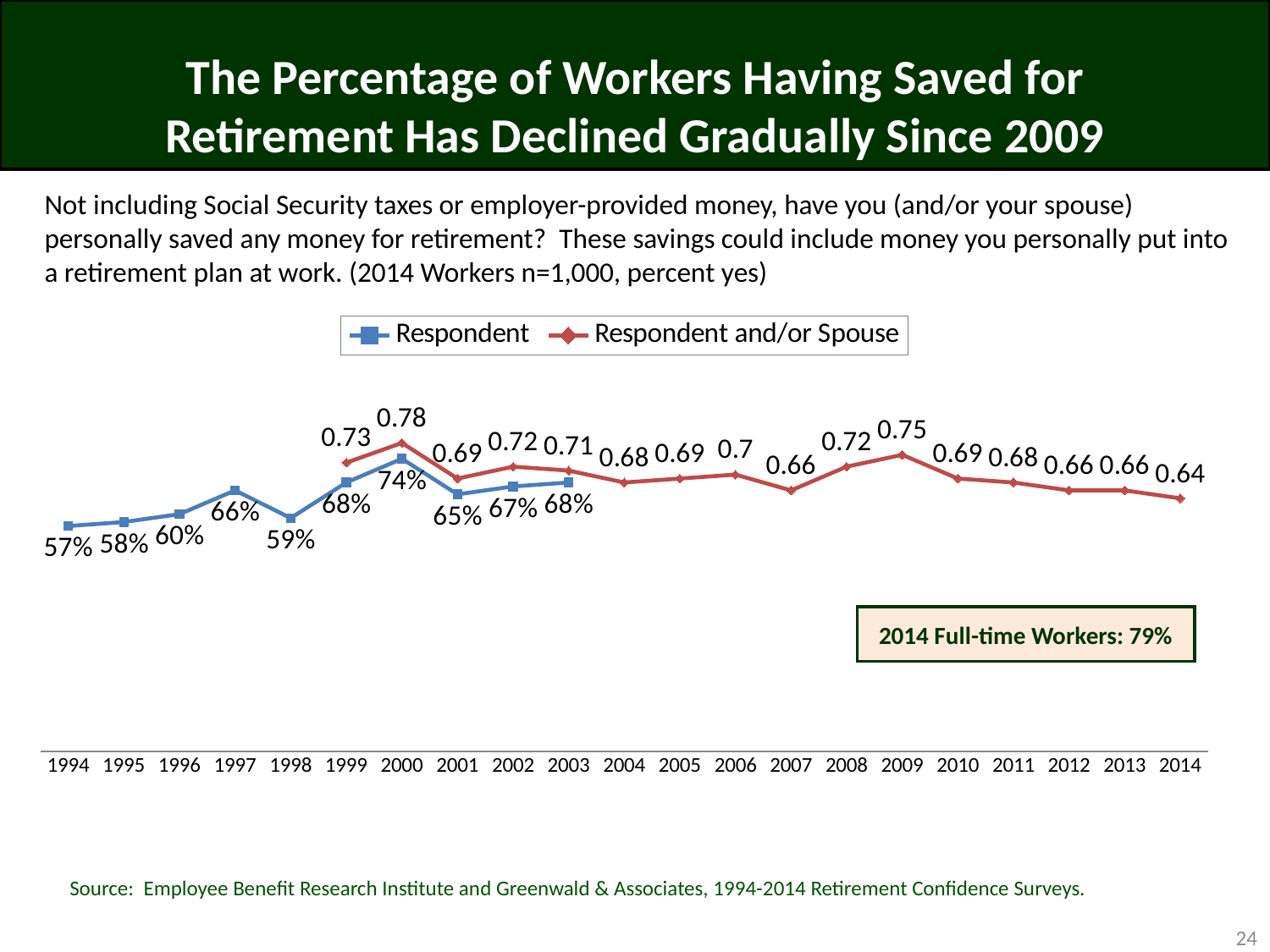
What kind of chart is shown on the slide? line chart What is the value for Respondent and/or Spouse in 2014? 0.64 How many years are shown on the x axis? 21 What is the difference between the Respondent and/or Spouse values for 2009 and 2014? 0.11 What is the value for Respondent in 1994? 57% In which year is the Respondent series lowest? 1994 How many series does the legend list? 2 What is the difference between the Respondent values for 2000 and 1994? 17% What is the value for Respondent in 2000? 74% In which year is the Respondent and/or Spouse series highest? 2000 Does the Respondent and/or Spouse series rise or fall from 2009 to 2014? fall Which year has the larger Respondent and/or Spouse value, 2009 or 2010? 2009